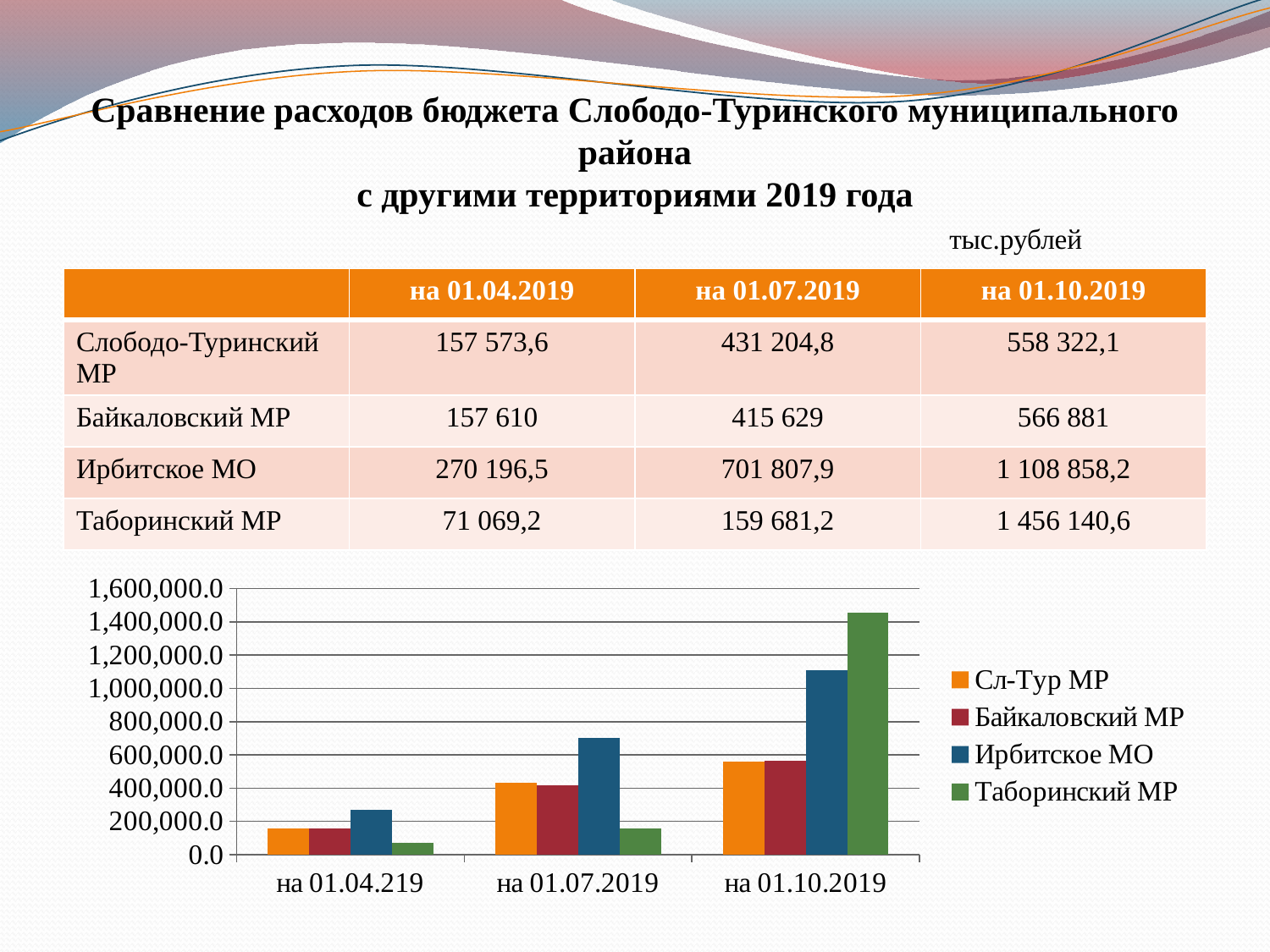
According to the table above the chart, what is the value for Ирбитское МО на 01.10.2019? 1 108 858,2 Which series has the highest bar for на 01.10.2019? Таборинский МР Which series has the lowest bar for на 01.04.219? Таборинский МР How many series does the chart legend list? 4 Which series has the highest bar for на 01.07.2019? Ирбитское МО What kind of chart is shown on the slide? bar chart Do the bars for Таборинский МР rise or fall from на 01.04.219 to на 01.10.2019? rise At на 01.10.2019, which bar is taller: Ирбитское МО or Сл-Тур МР? Ирбитское МО How many date categories are shown on the chart's x axis? 3 Is the bar for Таборинский МР at на 01.10.2019 greater or less than 1,400,000.0? greater Is the bar for Таборинский МР at на 01.04.219 greater or less than 200,000.0? less Is the bar for Ирбитское МО at на 01.07.2019 greater or less than 600,000.0? greater